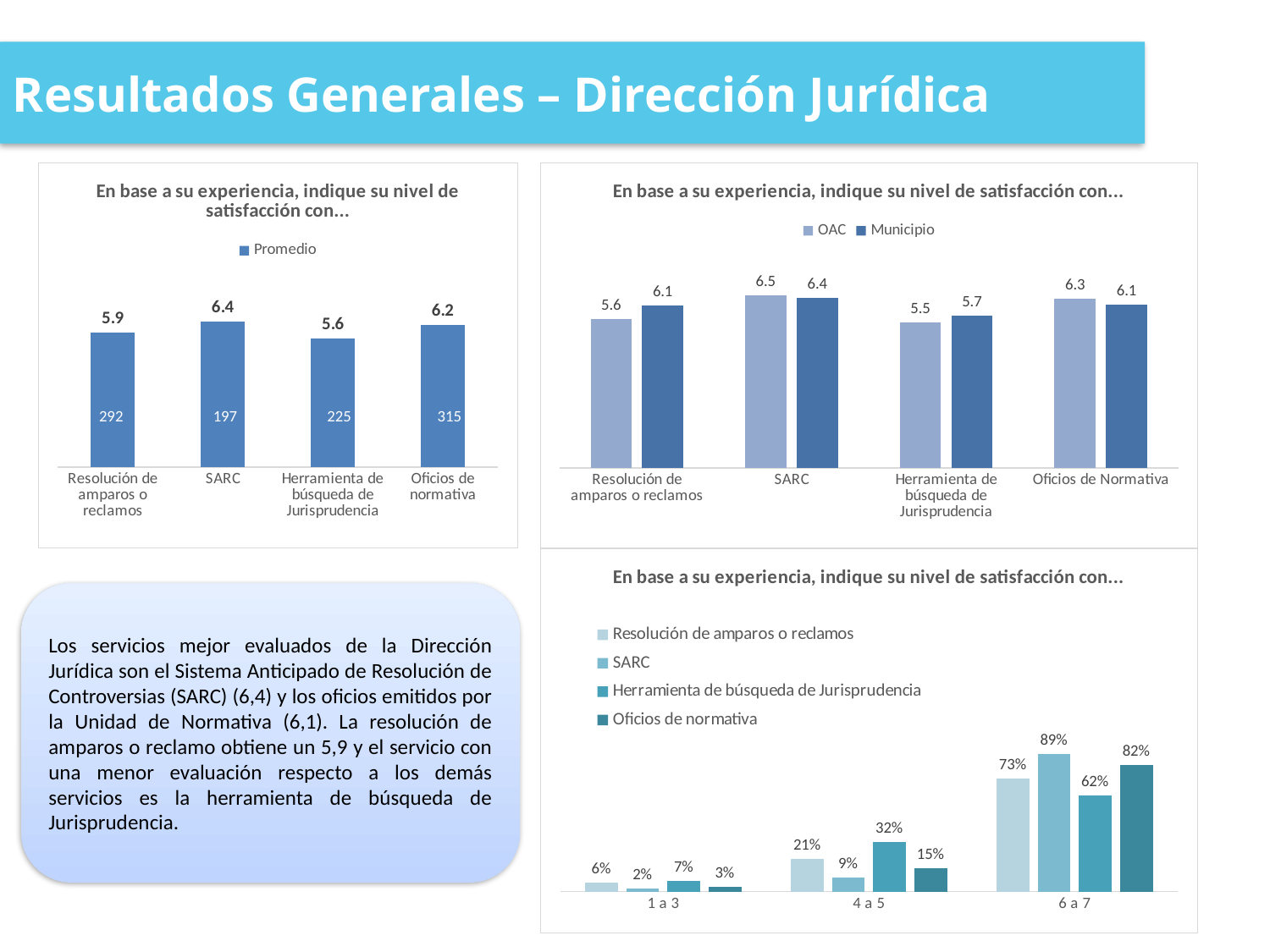
In the bottom-right chart, which series has the highest value in the 4 a 5 group? Herramienta de búsqueda de Jurisprudencia In the bottom-right chart, how many groups are shown on the x axis? 3 In the top-right chart, what is the OAC value for Herramienta de búsqueda de Jurisprudencia? 5.5 In the top-left chart, which category has the lowest Promedio value? Herramienta de búsqueda de Jurisprudencia In the top-left chart, what number is printed inside the bar for Oficios de normativa? 315 What type of chart is the top-left chart? Bar chart In the top-left chart, what is the difference between the Promedio values for SARC and Herramienta de búsqueda de Jurisprudencia? 0.8 In the top-left chart, what is the Promedio value for SARC? 6.4 In the top-right chart, what is the Municipio value for Resolución de amparos o reclamos? 6.1 In the bottom-right chart, what is the value for SARC in the 6 a 7 group? 89% In the top-right chart, how many series does the legend list? 2 In the top-right chart, which is larger for SARC, OAC or Municipio? OAC